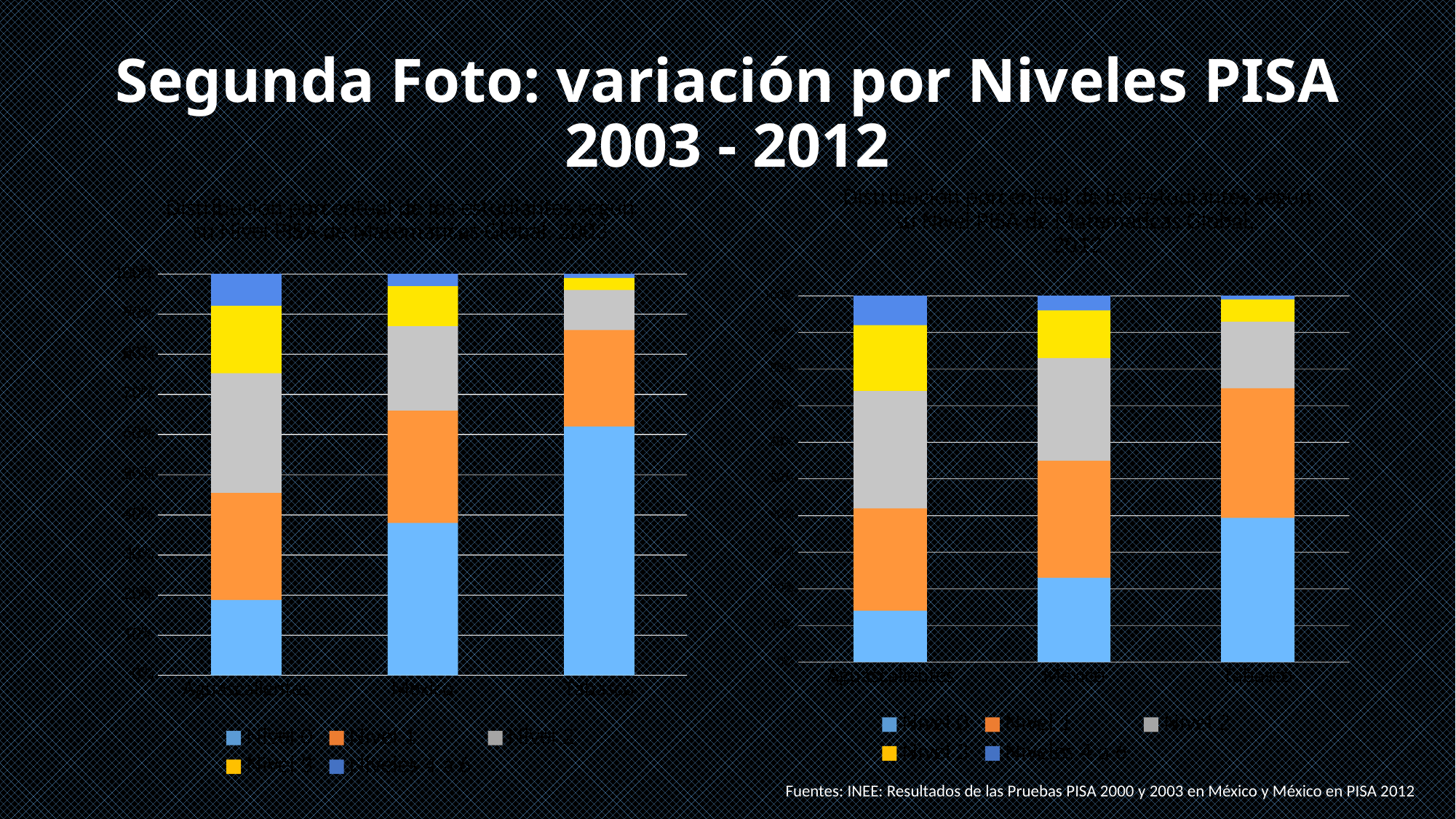
In the right chart, is the light-blue bottom segment larger in the first bar or in the third bar? The third bar What kind of chart is the chart on the right side of the slide? Stacked bar chart How many bars does the chart on the right side of the slide have? 3 What kind of chart is the chart on the left side of the slide? Stacked bar chart In the left chart, what colour is the bottom segment of each bar? Light blue How many bars does the chart on the left side of the slide have? 3 In the right chart, what colour is the top segment of each bar? Dark blue In the left chart, which bar has the largest light-blue bottom segment? The third (rightmost) bar How many series does the legend of the right chart list? 5 In the left chart, which bar has the smallest yellow segment? The third (rightmost) bar In the right chart, which bar has the largest grey segment? The first (leftmost) bar How many series does the legend of the left chart list? 5